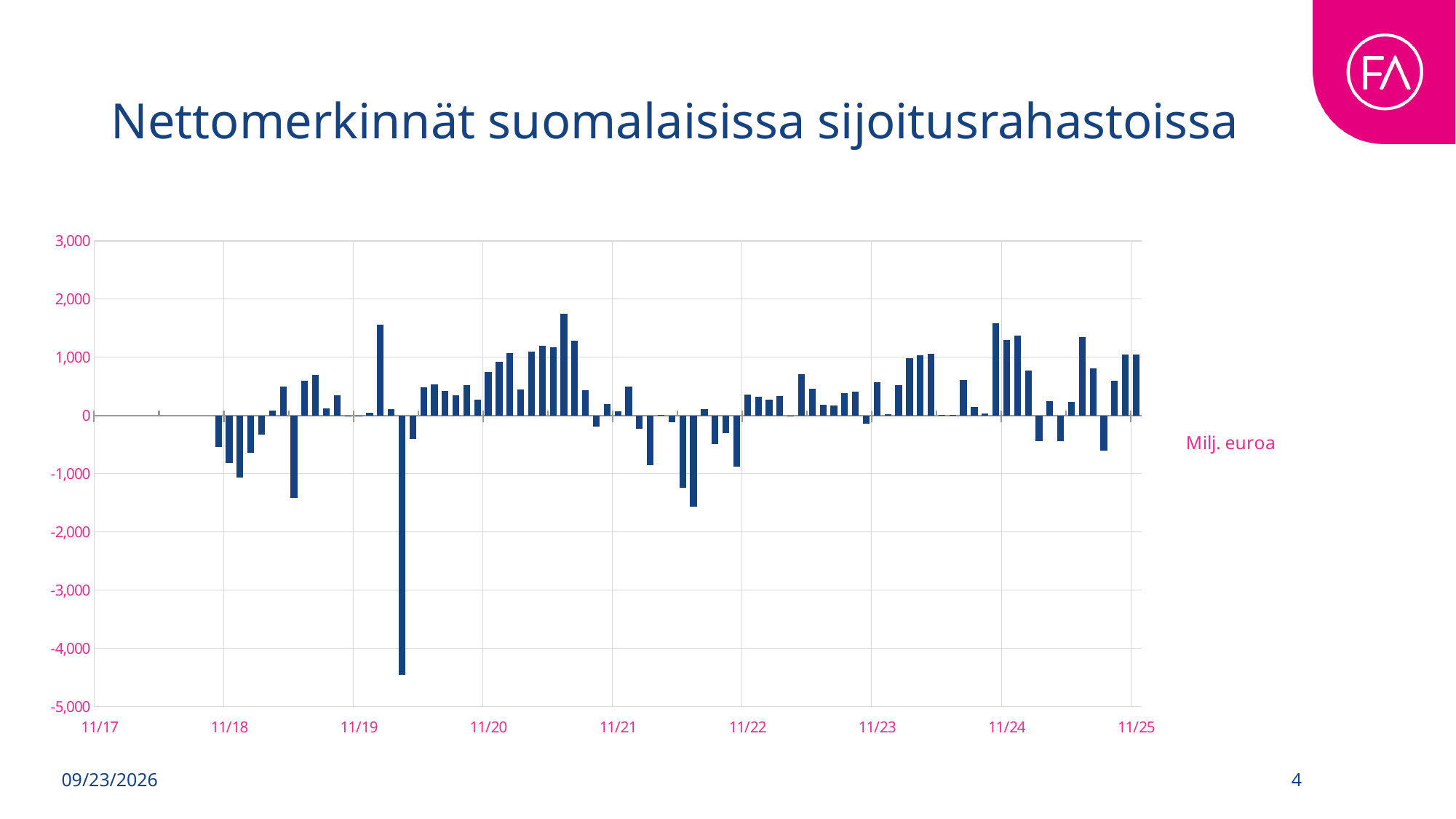
How many date labels are shown on the x axis of the chart? 9 What is the first date label on the x axis of the chart? 11/17 What is the title of the chart on the slide? Nettomerkinnät suomalaisissa sijoitusrahastoissa Is the value of the tallest bar near the 11/24 label greater or less than 1,000? greater What kind of chart is shown on the slide? bar chart Is the value of the lowest bar in the chart (the large negative bar between 11/19 and 11/20) greater or less than -4,000? less What unit is indicated next to the chart? Milj. euroa What is the lowest value shown on the y axis of the chart? -5,000 Which is larger in magnitude: the largest negative bar between 11/19 and 11/20, or the largest negative bar between 11/21 and 11/22? the bar between 11/19 and 11/20 What is the highest value shown on the y axis of the chart? 3,000 Is the value of the tallest positive bar in the chart (between 11/20 and 11/21) greater or less than 1,000? greater